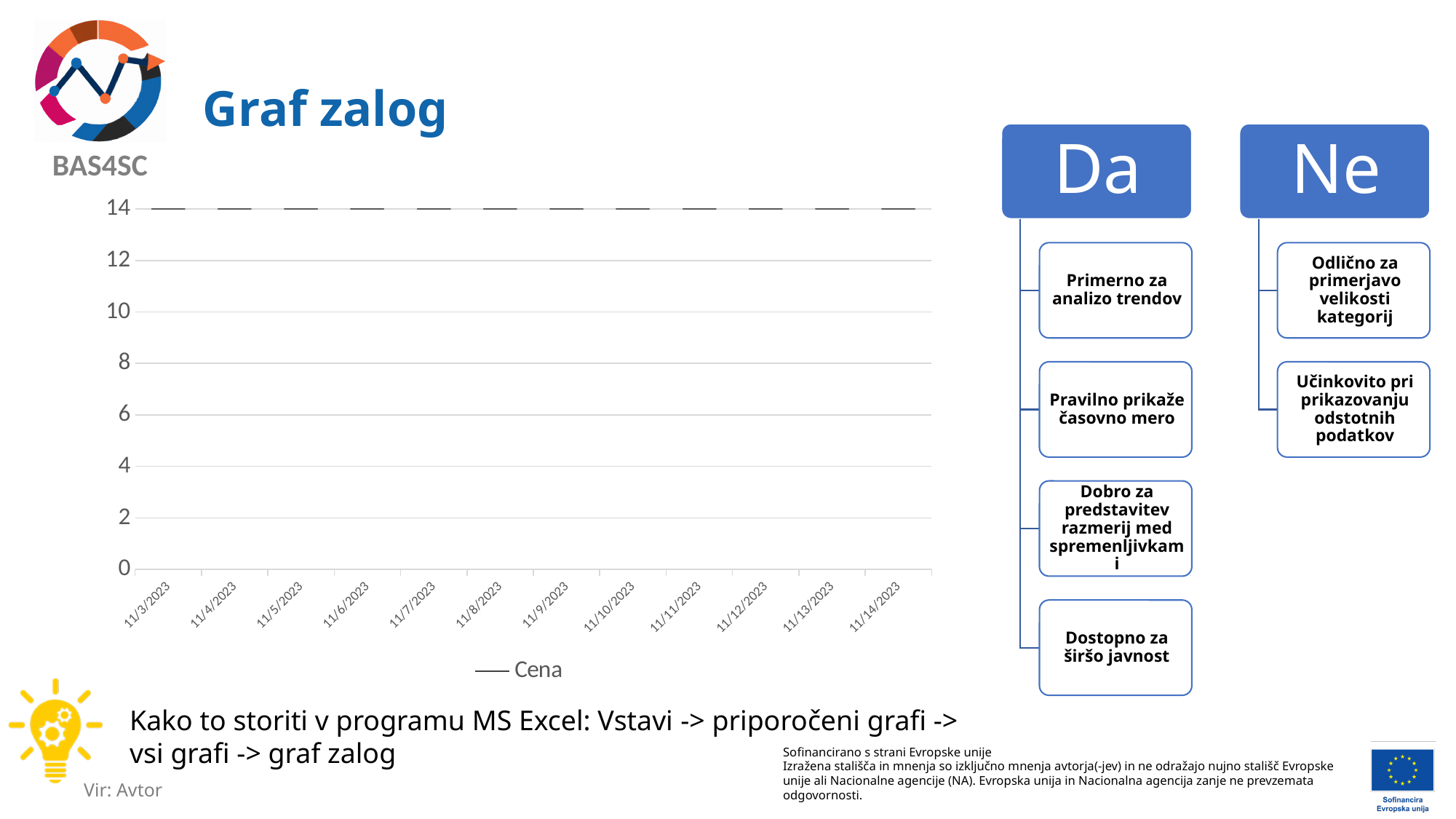
Do the plotted values rise, fall or stay flat from 11/3/2023 to 11/14/2023? stay flat What value does the mark for 11/3/2023 land on? 14 What is the first date shown on the x axis of the chart? 11/3/2023 What is the name of the series shown in the chart legend? Cena How many series does the chart legend list? 1 What is the highest value shown on the y axis of the chart? 14 Which of the two values is larger: 11/4/2023 or 11/10/2023, or are they equal? equal What is the last date shown on the x axis of the chart? 11/14/2023 Is the value for 11/5/2023 greater or less than 10? greater How many dates are shown on the x axis of the chart? 12 Is the value for 11/12/2023 greater or less than 12? greater